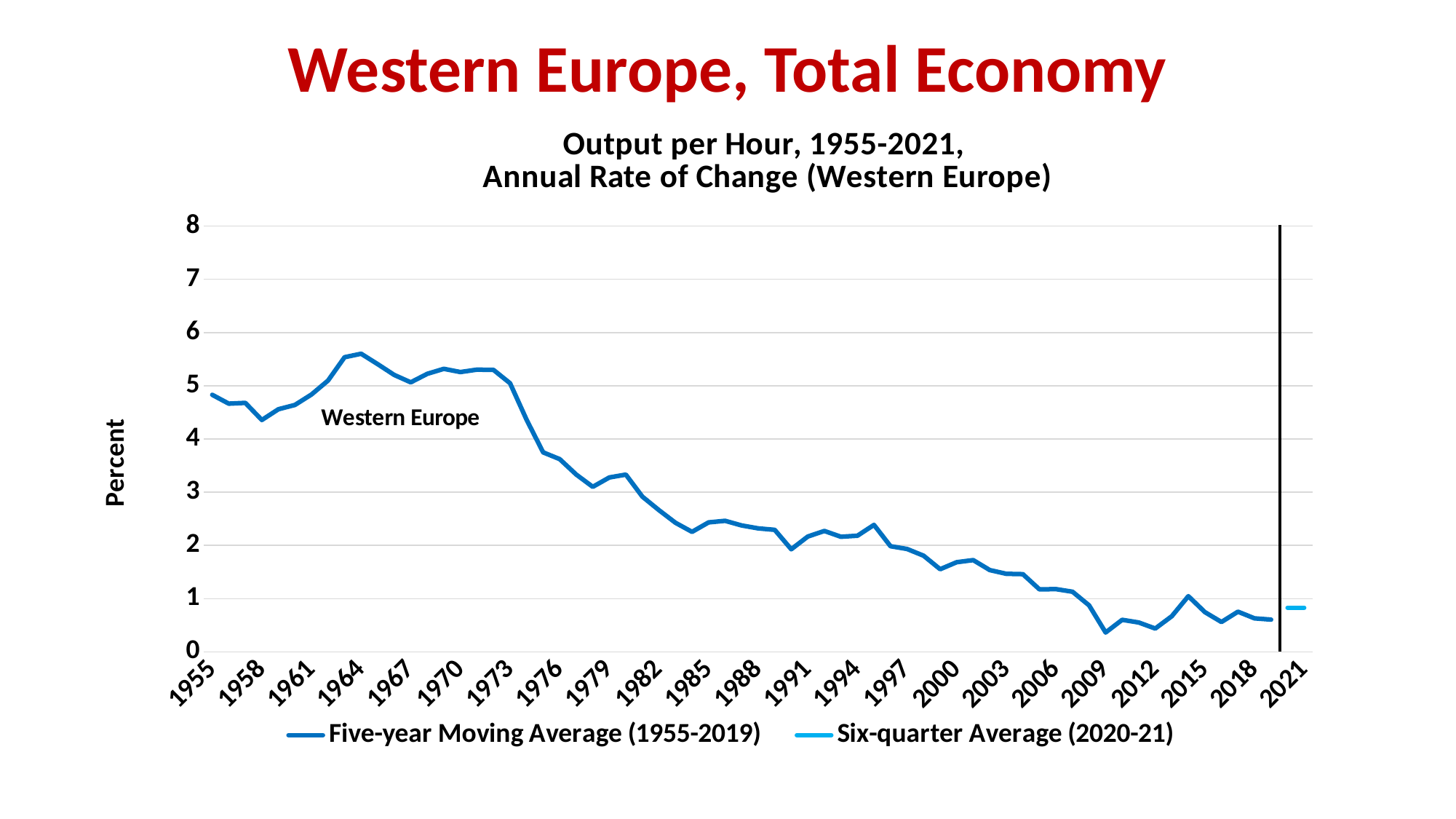
What kind of chart is shown on the slide? line chart Is the value for 2000 greater or less than 2? less Is the value for 1964 greater or less than 5? greater Is the value for 1976 greater or less than 3? greater What is the label on the vertical axis? Percent How many series does the legend list? 2 Overall, does the five-year moving average rise or fall from 1955 to 2019? fall What is the legend entry for the light blue series? Six-quarter Average (2020-21) Which is larger, the value for 1964 or the value for 2018? 1964